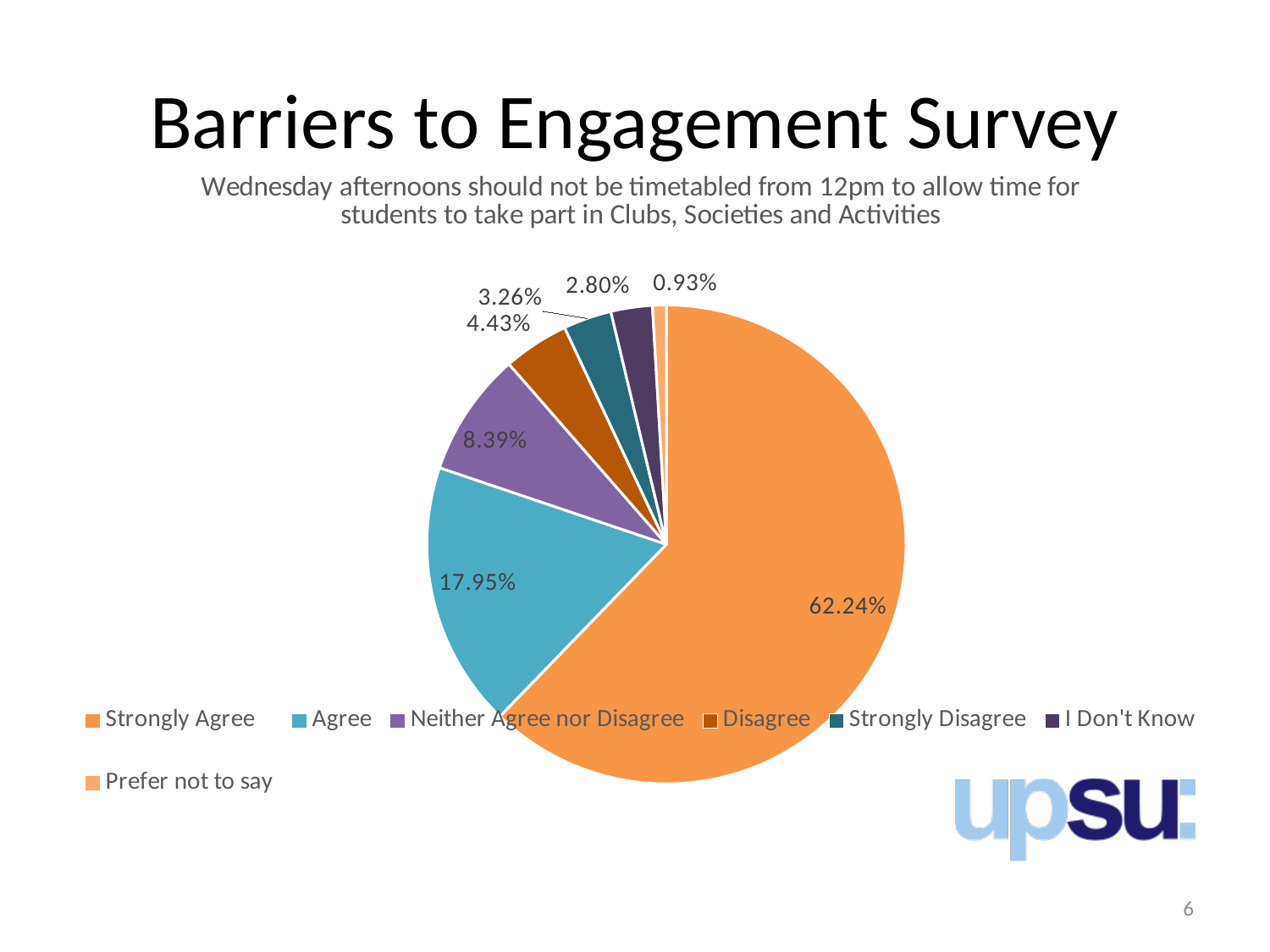
What is the value for Disagree? 4.43% How many categories does the legend list? 7 What is the value for Strongly Disagree? 3.26% What kind of chart is shown on the slide? Pie chart What is the difference between the Strongly Agree and Agree values? 44.29% What is the value for Prefer not to say? 0.93% Which is larger, Disagree or I Don't Know? Disagree Which category has the largest slice of the pie? Strongly Agree Which category has the smallest slice of the pie? Prefer not to say What is the value for Agree? 17.95% What share of the pie is Strongly Agree? 62.24% What is the value for Neither Agree nor Disagree? 8.39%